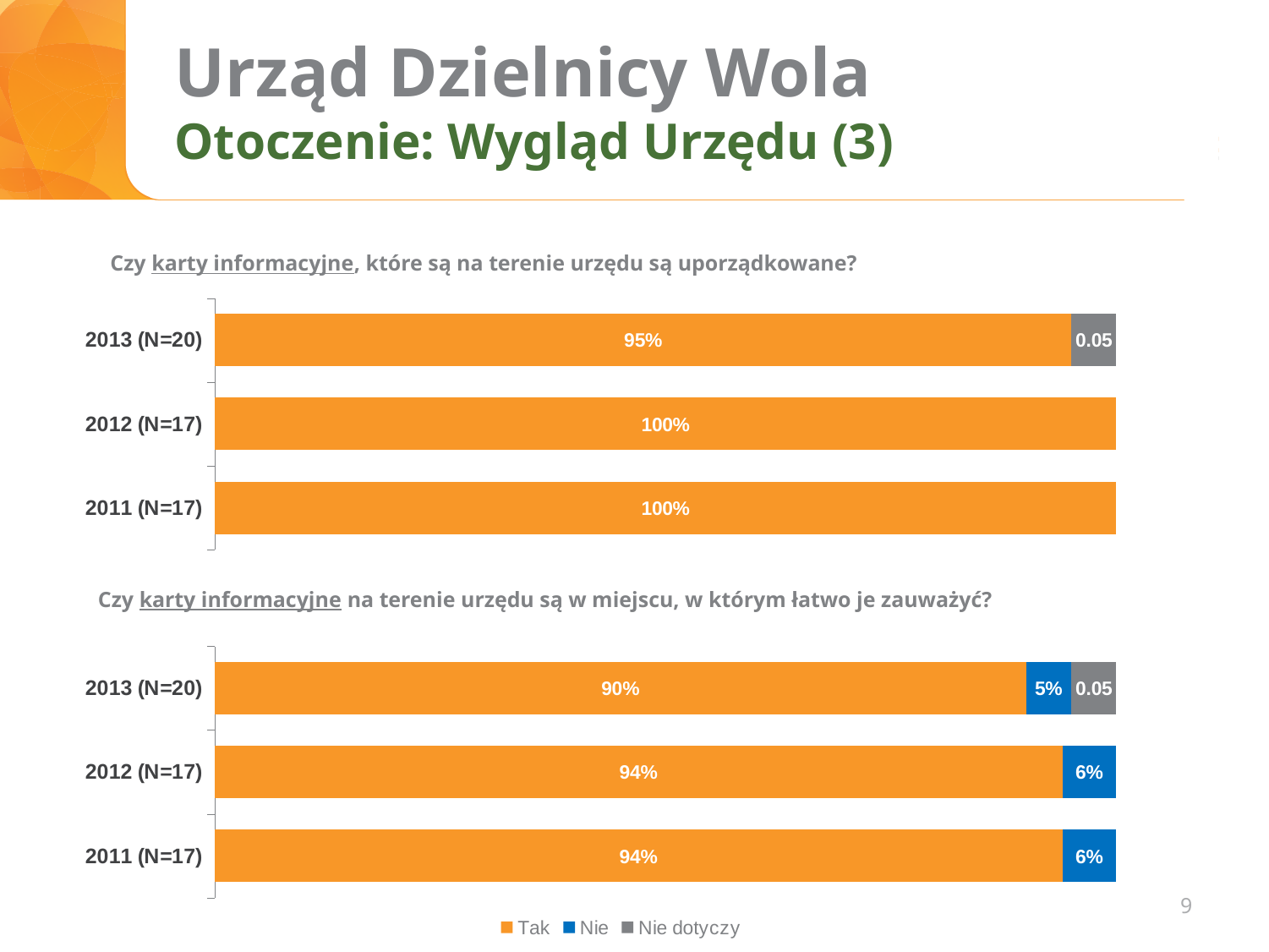
In the bottom chart, what is the 'Nie' value for 2012 (N=17)? 6% In the top chart, what is the 'Tak' value for 2013 (N=20)? 95% In the top chart, what is the 'Tak' value for 2012 (N=17)? 100% How many categories (years) does the top chart show? 3 How many series does the legend at the bottom of the slide list? 3 In the top chart, which year has the lowest 'Tak' value? 2013 (N=20) In the bottom chart, which year has the lowest 'Tak' value? 2013 (N=20) In the bottom chart, what is the 'Nie' value for 2013 (N=20)? 5% In the bottom chart, what is the difference between the 'Tak' values for 2012 (N=17) and 2013 (N=20)? 4% In the bottom chart, is the 'Tak' value for 2011 (N=17) larger or smaller than the 'Tak' value for 2013 (N=20)? larger In the bottom chart, what is the 'Tak' value for 2013 (N=20)? 90% In the top chart, what is the 'Nie dotyczy' value shown for 2013 (N=20)? 0.05